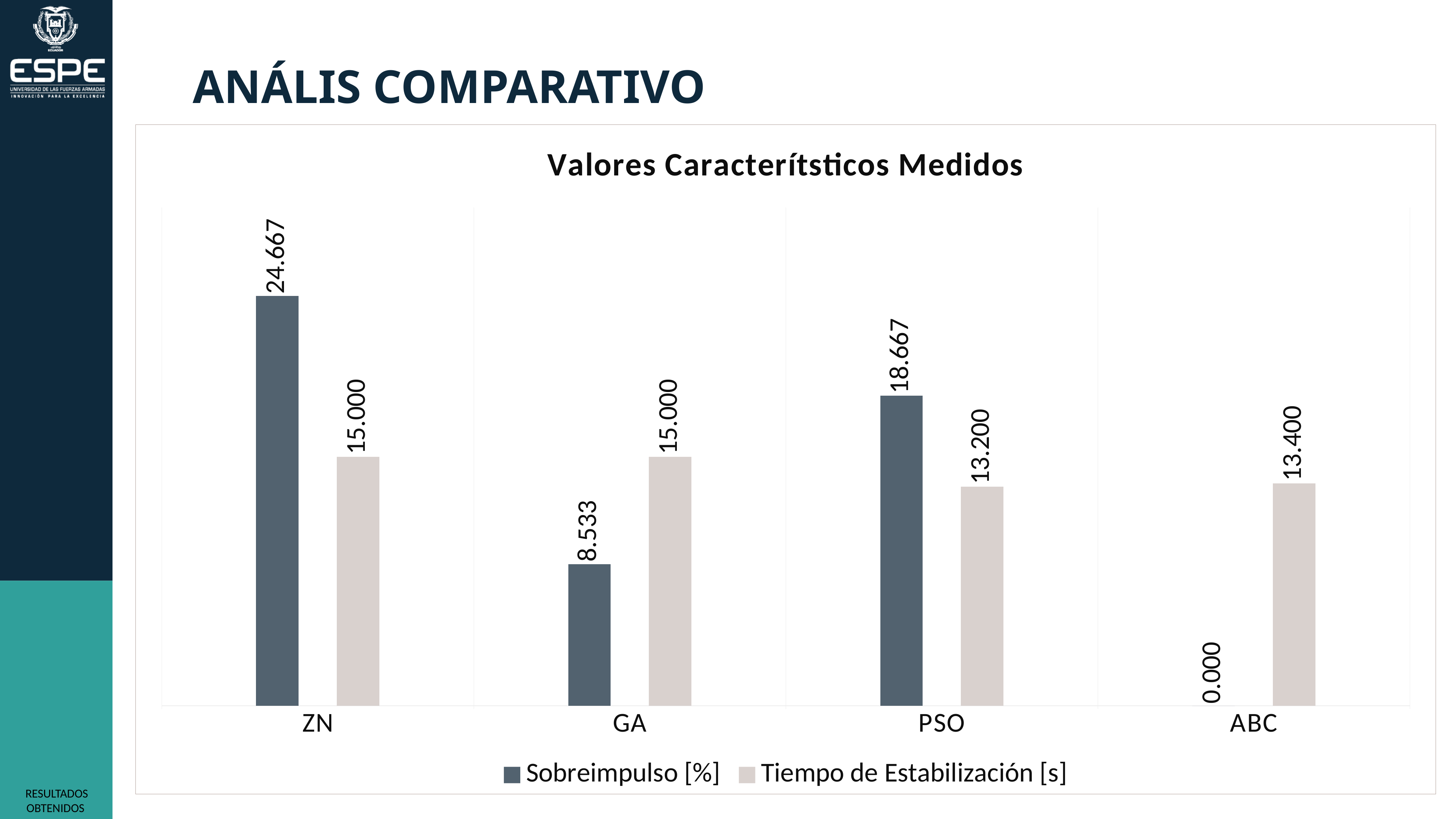
What is the difference between the Sobreimpulso [%] values for ZN and PSO? 6.000 What is the Tiempo de Estabilización [s] value for ABC? 13.400 How many series does the legend list? 2 Which category has the lowest Sobreimpulso [%] value? ABC What is the Sobreimpulso [%] value for ZN? 24.667 What is the Tiempo de Estabilización [s] value for PSO? 13.200 How many categories are shown on the x axis? 4 What is the Sobreimpulso [%] value for ABC? 0.000 Which is larger: the Sobreimpulso [%] value for GA or the Sobreimpulso [%] value for PSO? PSO Which category has the lowest Tiempo de Estabilización [s] value? PSO What type of chart is shown? Bar chart Which category has the highest Sobreimpulso [%] value? ZN